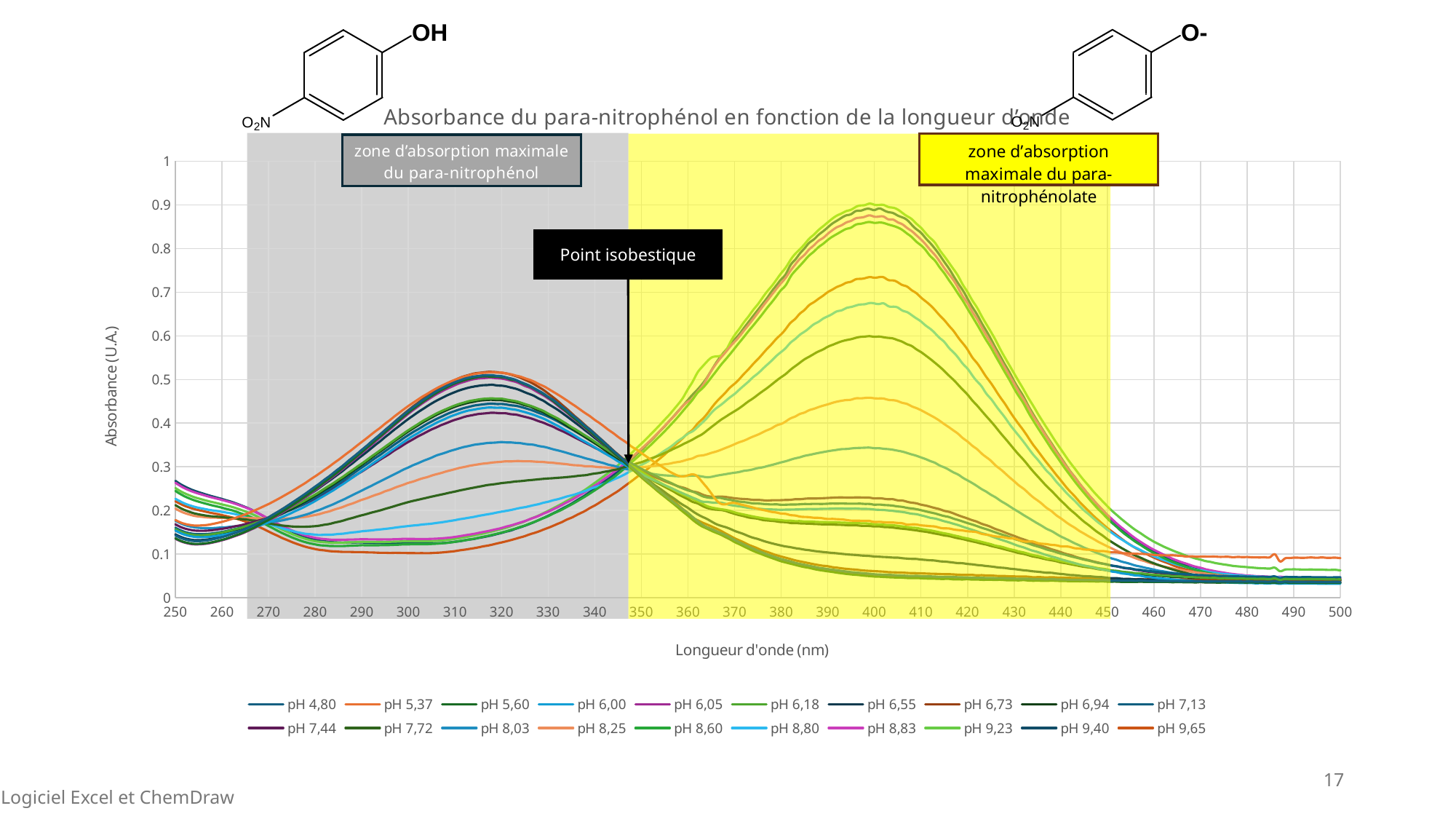
Is the absorbance at the isosbestic point (where the curves cross near 347 nm) greater or less than 0.4? less Is the absorbance at the isosbestic point (where the curves cross near 347 nm) greater or less than 0.2? greater How many tick labels are shown on the y axis? 11 Is the highest absorbance value plotted on the chart (near 400 nm) greater or less than 0.8? greater What is the label of the x axis? Longueur d'onde (nm) What is the title of the chart? Absorbance du para-nitrophénol en fonction de la longueur d'onde Between 400 nm and 500 nm, does the highest curve rise or fall? fall How many series does the legend list? 20 What kind of chart is shown on the slide? line chart How many tick labels are shown on the x axis? 26